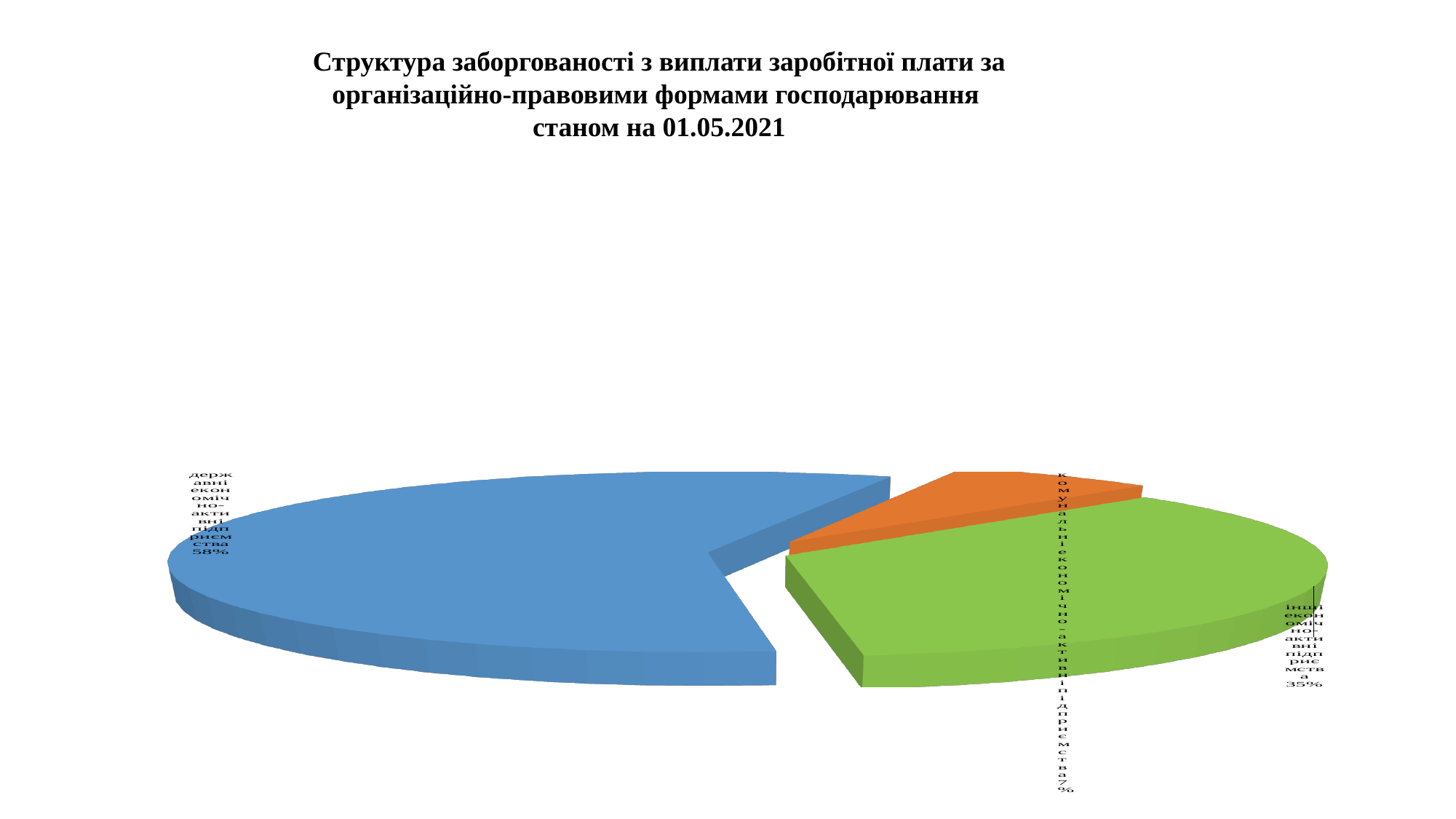
What share of the pie is labelled for державні економічно-активні підприємства? 58% What colour is the slice for державні економічно-активні підприємства? blue Which slice is larger: інші економічно-активні підприємства or комунальні економічно-активні підприємства? інші економічно-активні підприємства What share of the pie is labelled for інші економічно-активні підприємства? 35% What is the difference in percentage points between the державні and інші економічно-активні підприємства slices? 23 What is the difference in percentage points between the інші and комунальні економічно-активні підприємства slices? 28 How many slices does the pie chart have? 3 Which category has the smallest slice of the pie? комунальні економічно-активні підприємства Which category has the largest slice of the pie? державні економічно-активні підприємства What share of the pie is labelled for комунальні економічно-активні підприємства? 7% As of what date does the chart title say the data is given? 01.05.2021 What kind of chart is shown on the slide? pie chart